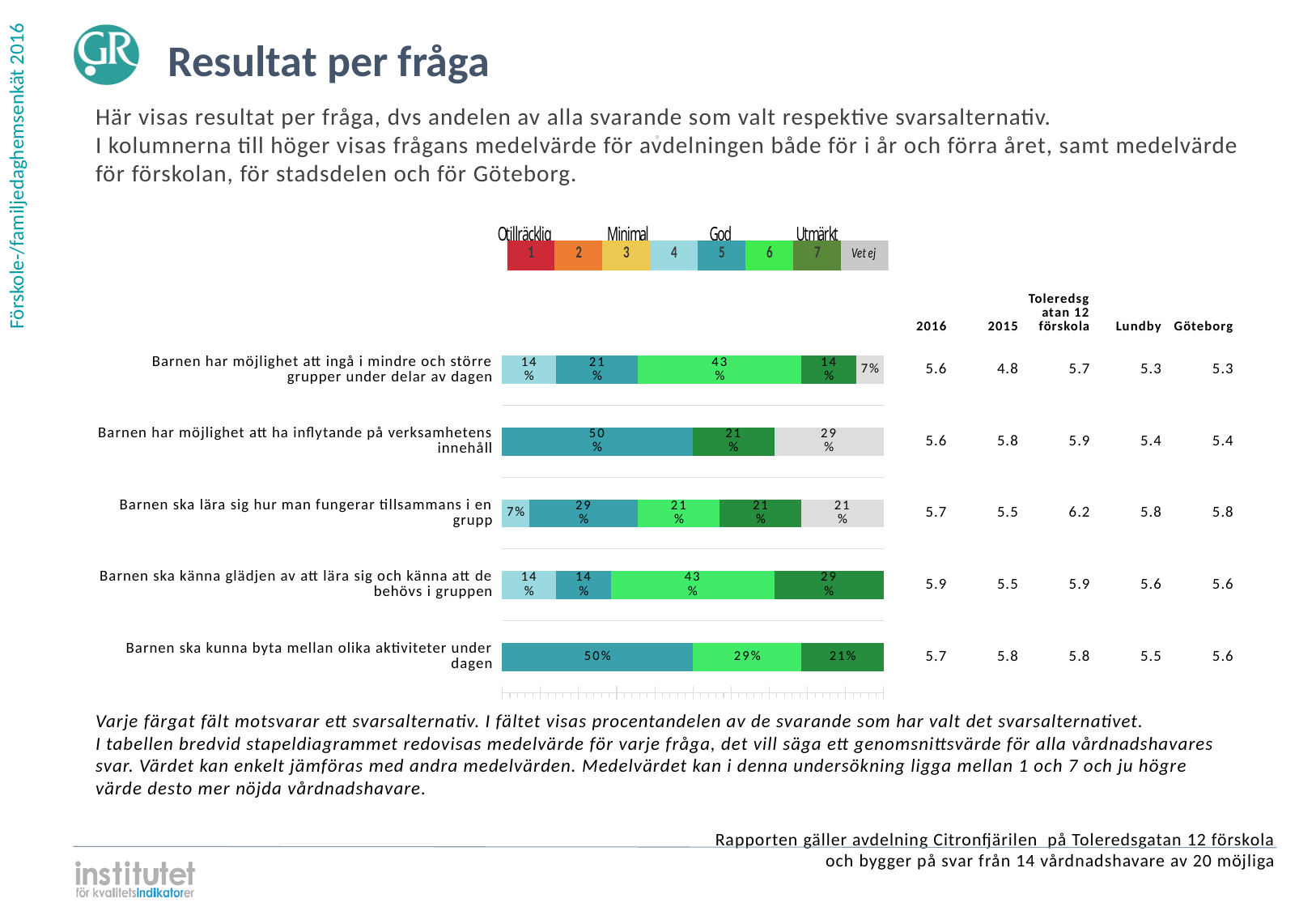
What percentage of respondents chose answer alternative 6 (bright green) for 'Barnen har möjlighet att ingå i mindre och större grupper under delar av dagen'? 43% What percentage of respondents chose answer alternative 7 (dark green) for 'Barnen ska känna glädjen av att lära sig och känna att de behövs i gruppen'? 29% What label does the legend give to answer alternative 7? Utmärkt How many questions (bars) are shown in the chart? 5 What is the combined share of answer alternatives 6 and 7 for 'Barnen ska känna glädjen av att lära sig och känna att de behövs i gruppen'? 72% How many answer alternatives does the legend above the chart list? 8 For 'Barnen ska kunna byta mellan olika aktiviteter under dagen', which answer alternative has a larger share: 6 (bright green) or 7 (dark green)? 6 (bright green) What percentage of respondents chose answer alternative 5 (teal) for 'Barnen ska kunna byta mellan olika aktiviteter under dagen'? 50% Which question has the highest 2016 mean value in the table next to the chart? Barnen ska känna glädjen av att lära sig och känna att de behövs i gruppen For 'Barnen ska lära sig hur man fungerar tillsammans i en grupp', what is the difference between the share choosing alternative 5 (29%) and the share choosing alternative 4 (7%)? 22 percentage points What kind of chart is used to show the share of respondents choosing each answer alternative? Stacked bar chart What percentage of respondents chose 'Vet ej' for 'Barnen har möjlighet att ha inflytande på verksamhetens innehåll'? 29%